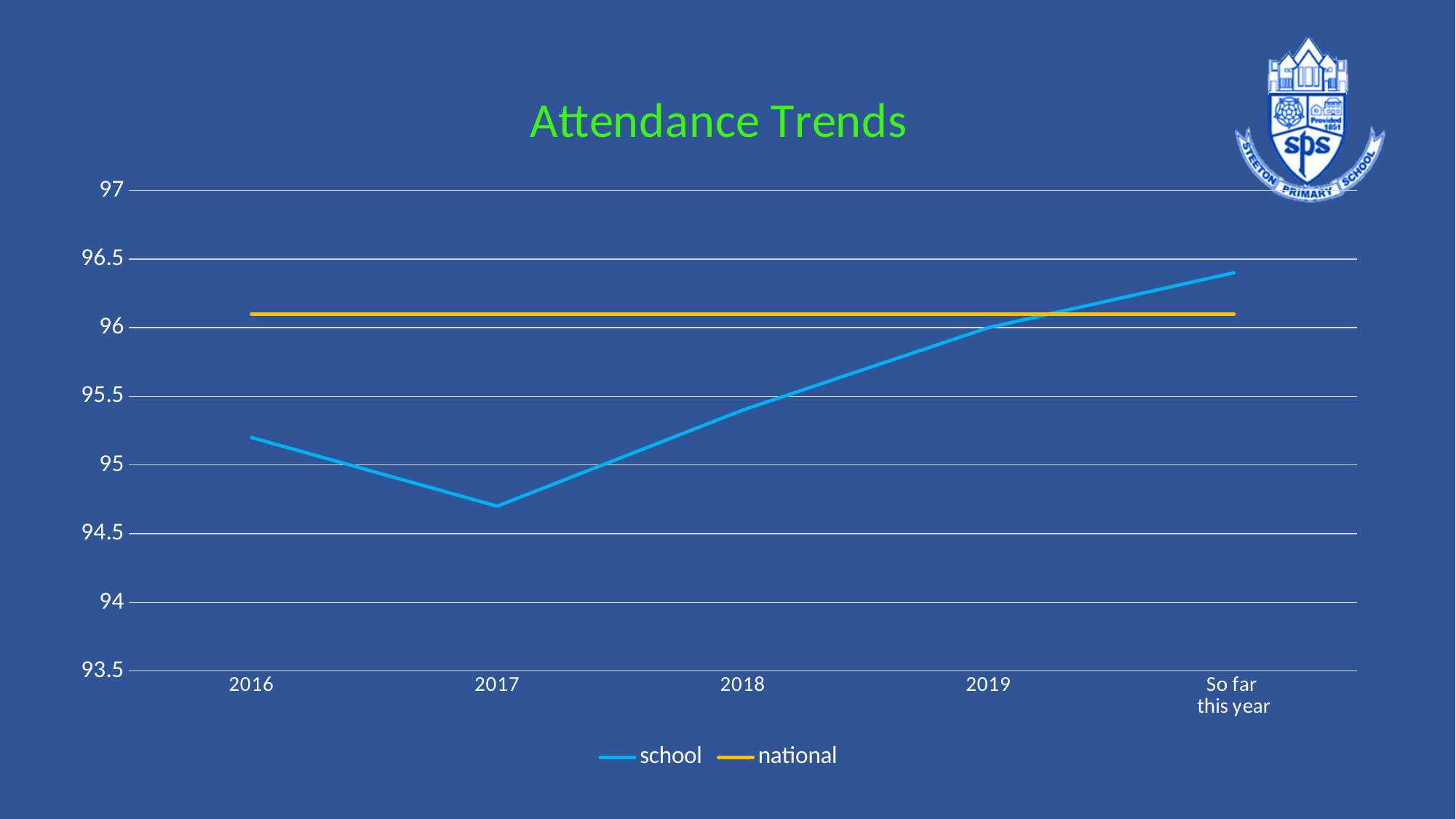
Is the school value for So far this year greater or less than 96? greater How many categories are shown along the x axis? 5 Is the school value for 2016 greater or less than 95? greater Which is larger, the school value for 2016 or the school value for 2017? 2016 How many series does the legend list? 2 In 2016, which series has the higher value, school or national? national At which x-axis category is the school attendance line at its highest? So far this year Is the national value greater or less than 96.5? less What kind of chart is shown on the slide? line chart In which year is the school attendance line at its lowest? 2017 Does the school line rise or fall from 2017 to So far this year? rise